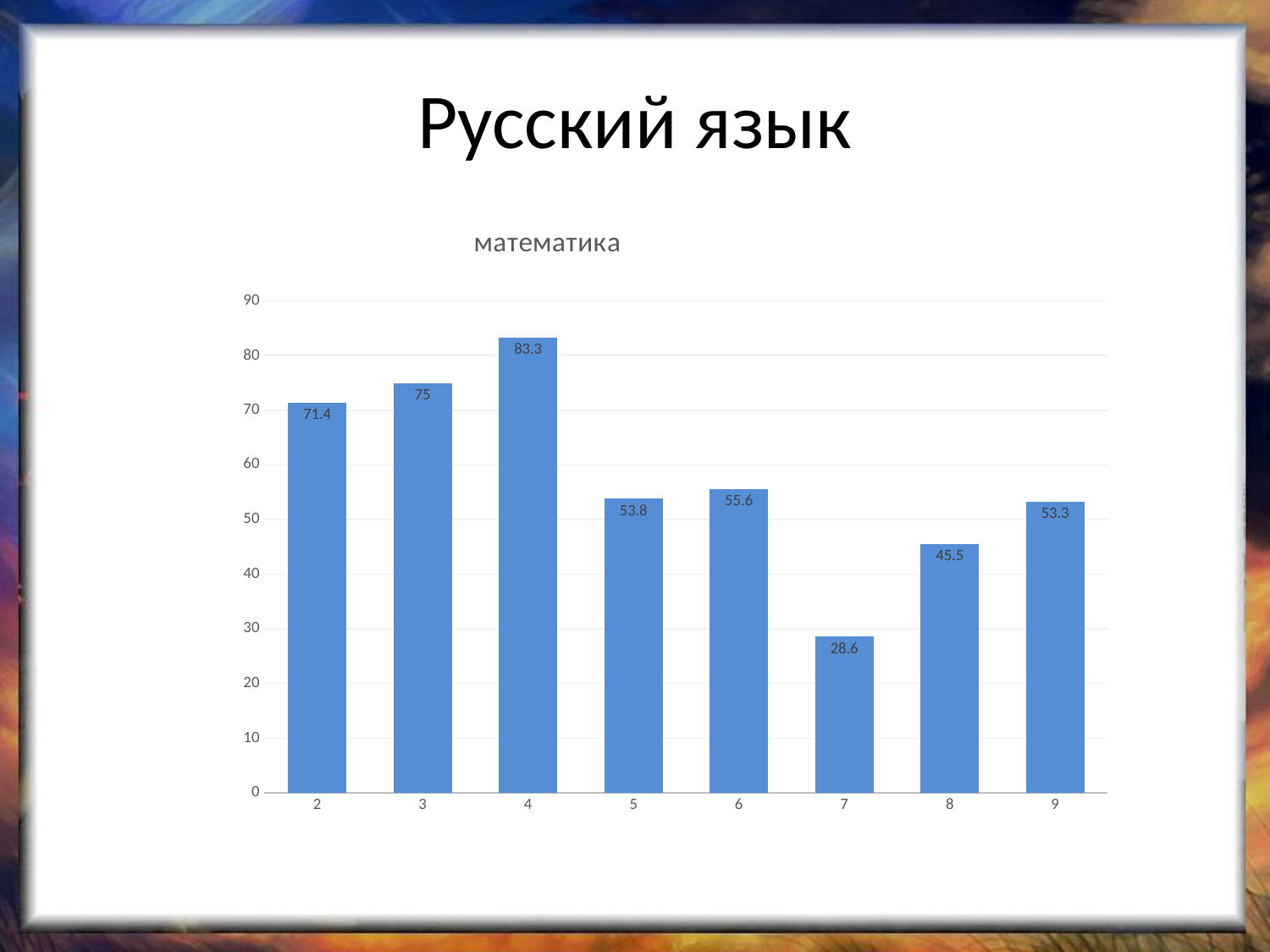
What kind of chart is shown on the slide? bar chart What is the difference between the values for category 3 and category 2? 3.6 Which is larger, the value for category 6 or the value for category 8? 6 Is the value for category 8 greater or less than 50? less What is the value for category 9? 53.3 Which category has the lowest value? 7 What is the value for category 4? 83.3 What is the difference between the values for category 4 and category 7? 54.7 Which category has the highest value? 4 How many categories are shown on the x axis? 8 What is the value for category 7? 28.6 What is the title of the chart? математика